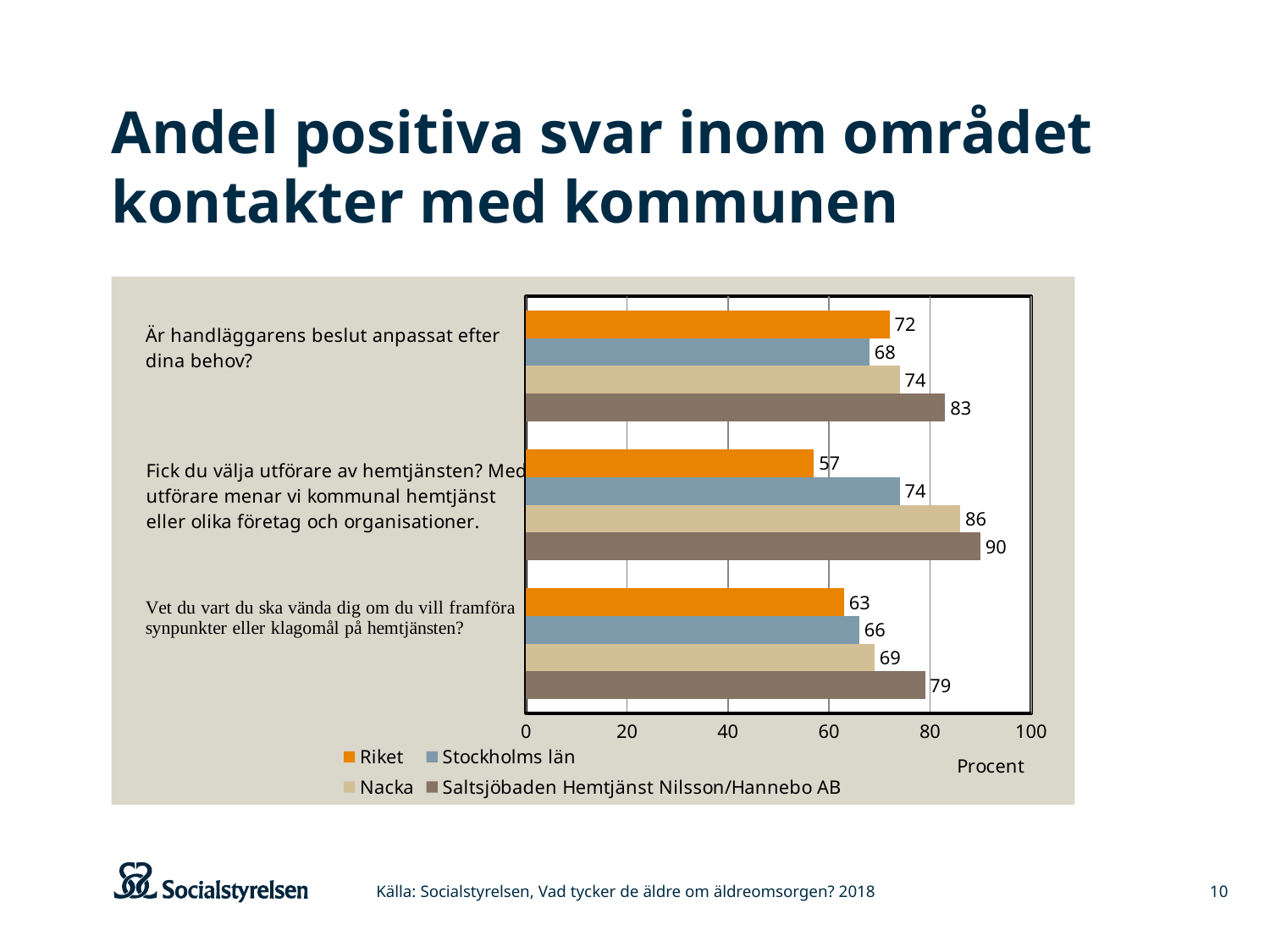
What kind of chart is shown on the slide? bar chart How many series does the legend list? 4 Is the value for Nacka on "Fick du välja utförare av hemtjänsten?" greater or less than 80? greater How many question categories are plotted on the chart? 3 Which series has the lowest value for "Är handläggarens beslut anpassat efter dina behov?" Stockholms län What is the value for Nacka on "Vet du vart du ska vända dig om du vill framföra synpunkter eller klagomål på hemtjänsten?" 69 What is the label of the x axis? Procent Which is larger on "Vet du vart du ska vända dig om du vill framföra synpunkter eller klagomål på hemtjänsten?": Riket or Stockholms län? Stockholms län What is the value for Saltsjöbaden Hemtjänst Nilsson/Hannebo AB on "Fick du välja utförare av hemtjänsten?" 90 What is the value for Riket on "Är handläggarens beslut anpassat efter dina behov?" 72 What is the difference between Saltsjöbaden Hemtjänst Nilsson/Hannebo AB and Riket on "Fick du välja utförare av hemtjänsten?" 33 Which series has the highest value for "Fick du välja utförare av hemtjänsten?" Saltsjöbaden Hemtjänst Nilsson/Hannebo AB